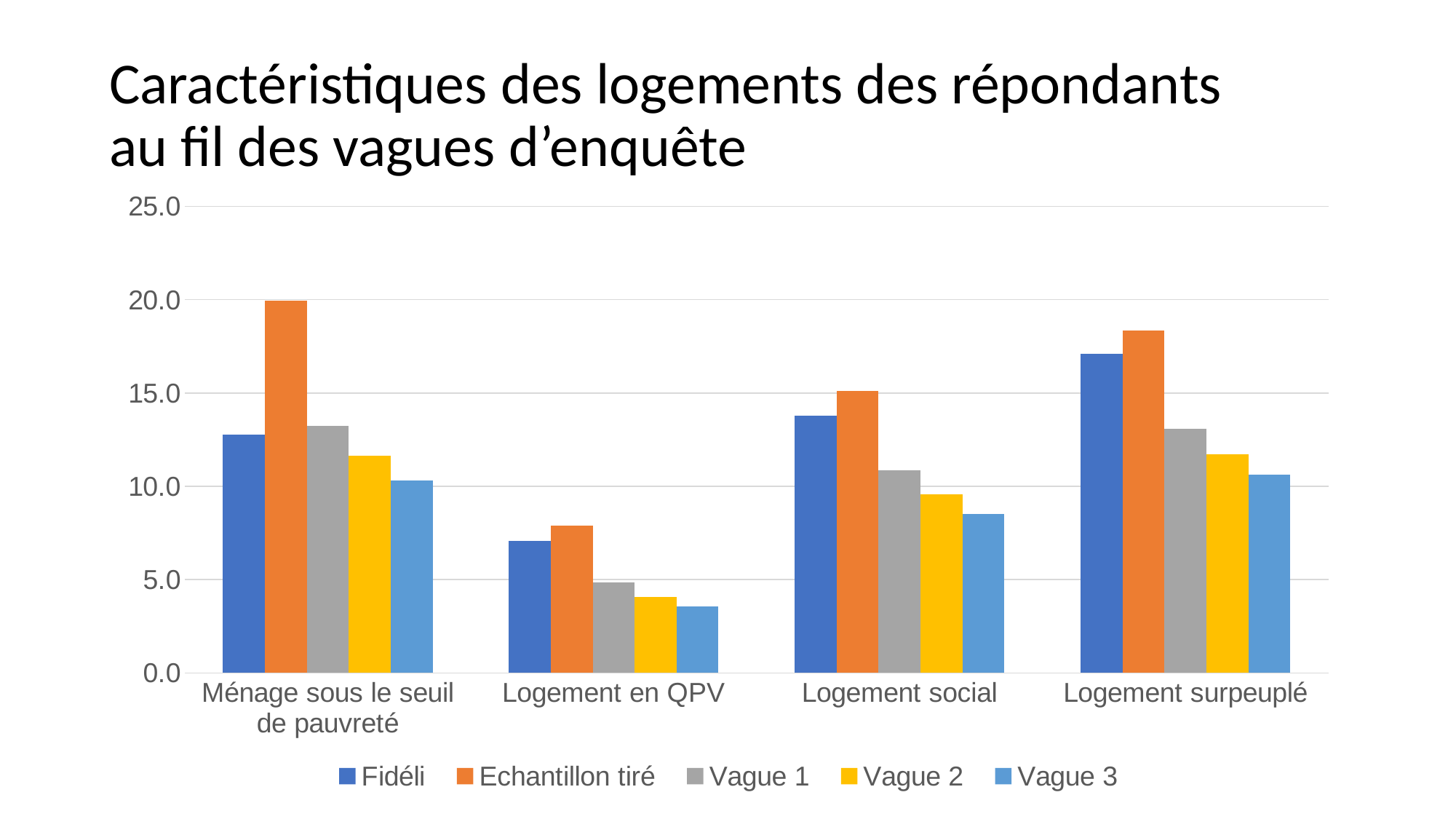
For Logement en QPV, do the values rise or fall from Vague 1 to Vague 3? fall What colour represents the Echantillon tiré series in the legend? Orange How many series does the legend list? 5 For which category is the Vague 3 bar the lowest? Logement en QPV For Logement social, which is larger: the Fidéli value or the Vague 1 value? Fidéli What kind of chart is shown on the slide? Bar chart For which category is the Echantillon tiré bar the highest? Ménage sous le seuil de pauvreté How many categories are shown on the x axis of the chart? 4 What is the title of the slide? Caractéristiques des logements des répondants au fil des vagues d'enquête Is the Vague 3 value for Logement social greater or less than 10.0? less Is the Vague 2 value for Ménage sous le seuil de pauvreté greater or less than 10.0? greater Is the Fidéli value for Logement surpeuplé greater or less than 15.0? greater